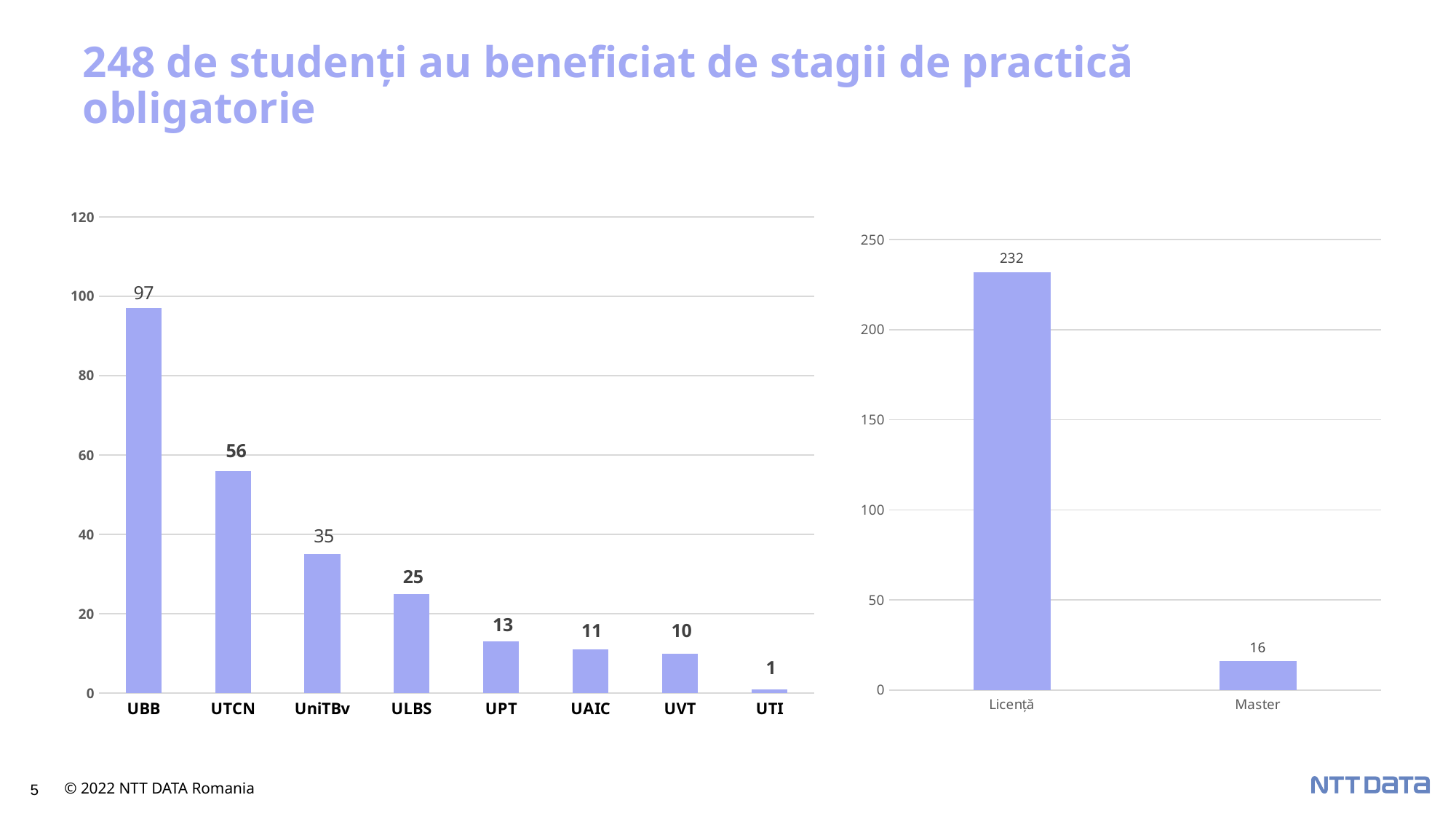
What kind of chart is the left chart? bar chart In the left chart, what is the value for UBB? 97 In the left chart, what is the difference between the values for UBB and UTCN? 41 In the left chart, how many universities are shown on the x axis? 8 In the left chart, what is the value for ULBS? 25 In the right chart, is the value for Licență greater or less than 200? greater In the left chart, which university has the lowest value? UTI In the left chart, do the values rise or fall from left to right along the x axis? fall In the left chart, which is larger, the value for UAIC or the value for UVT? UAIC In the left chart, which university has the highest value? UBB In the right chart, what is the difference between the values for Licență and Master? 216 In the right chart, what is the value for Master? 16